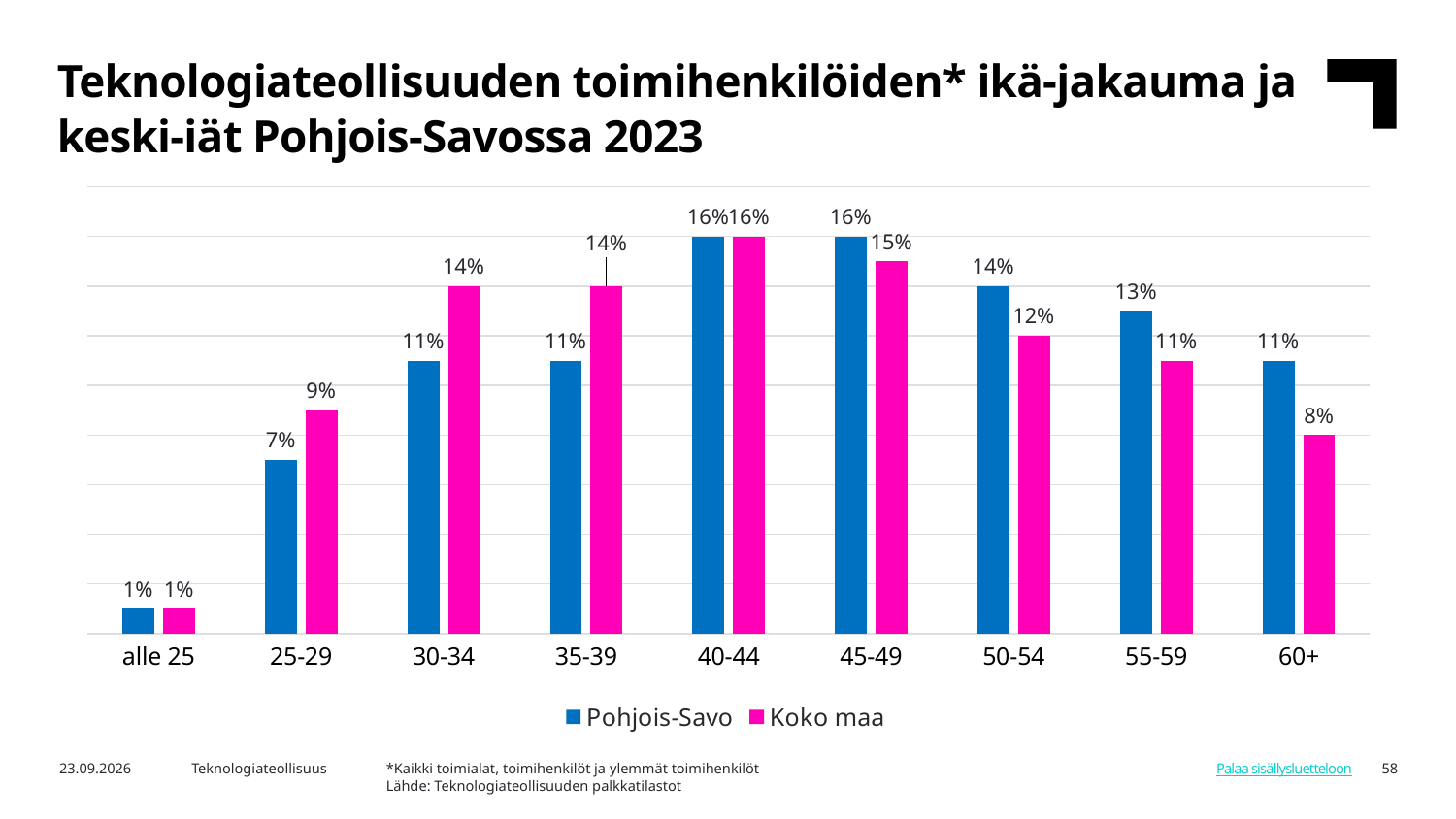
What is the value for Pohjois-Savo in the 25-29 age group? 7% What kind of chart is shown on the slide? Bar chart What is the difference between Pohjois-Savo and Koko maa in the 60+ age group? 3% What is the value for Koko maa in the 30-34 age group? 14% Which age group has the highest value for Koko maa? 40-44 How many series does the legend list? 2 What is the value for Pohjois-Savo in the 55-59 age group? 13% In the 50-54 age group, which series has the larger value, Pohjois-Savo or Koko maa? Pohjois-Savo Which age group has the lowest value for Pohjois-Savo? alle 25 What is the difference between Koko maa and Pohjois-Savo in the 30-34 age group? 3% How many age groups are shown on the x axis? 9 What is the value for Koko maa in the 60+ age group? 8%